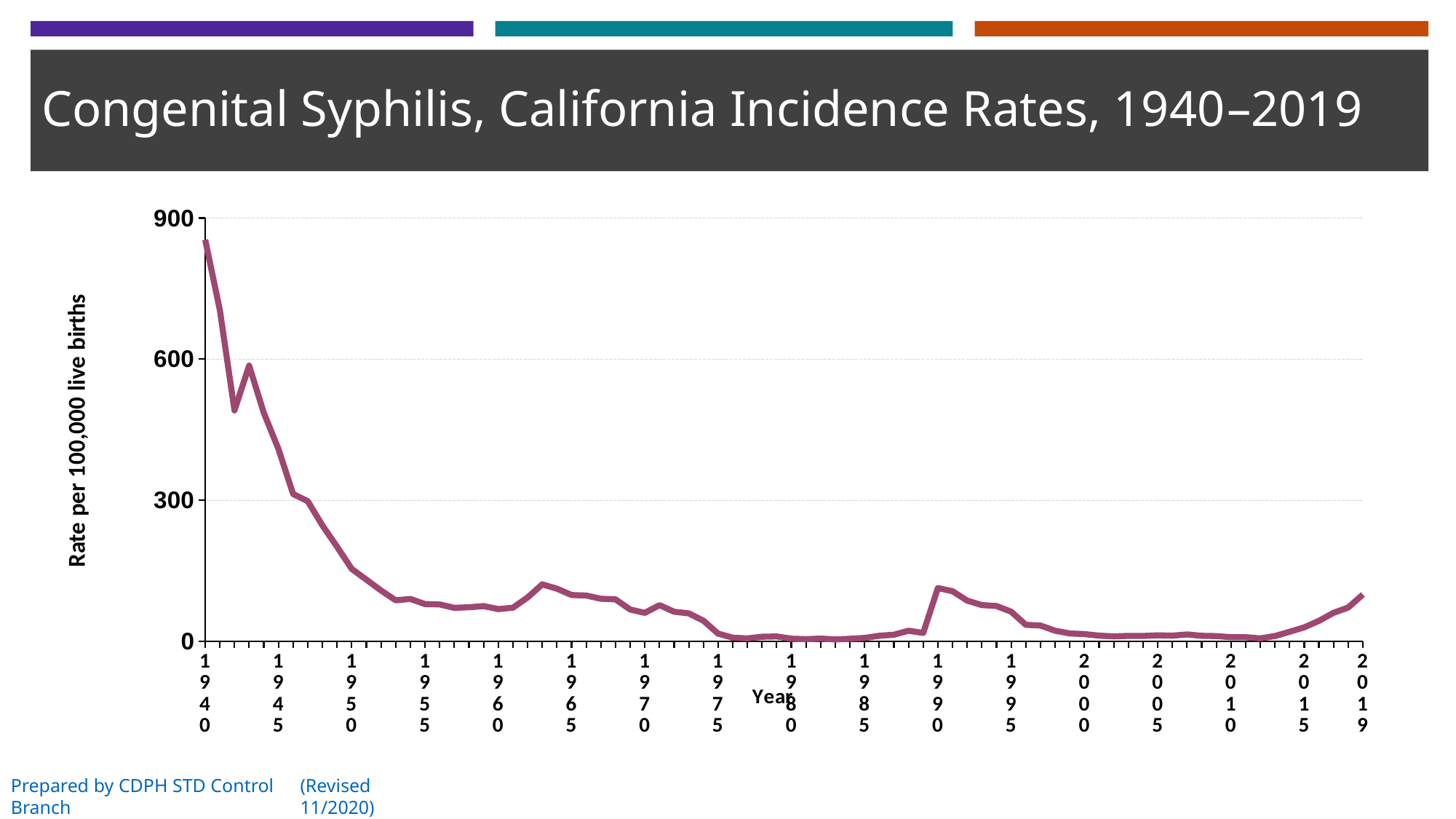
Which year has the larger incidence rate, 1950 or 1960? 1950 What is the label on the vertical axis of the chart? Rate per 100,000 live births Which year has the larger incidence rate, 1940 or 2019? 1940 What is the title of the chart? Congenital Syphilis, California Incidence Rates, 1940–2019 What kind of chart is shown on the slide? line chart Is the value for 2019 greater or less than 300? less Does the incidence rate rise or fall between 1940 and 1950? fall Is the value for 1940 greater or less than 600? greater Which year has the larger incidence rate, 1980 or 1990? 1990 Is the value for 1950 greater or less than 300? less Which year has the highest incidence rate on the chart? 1940